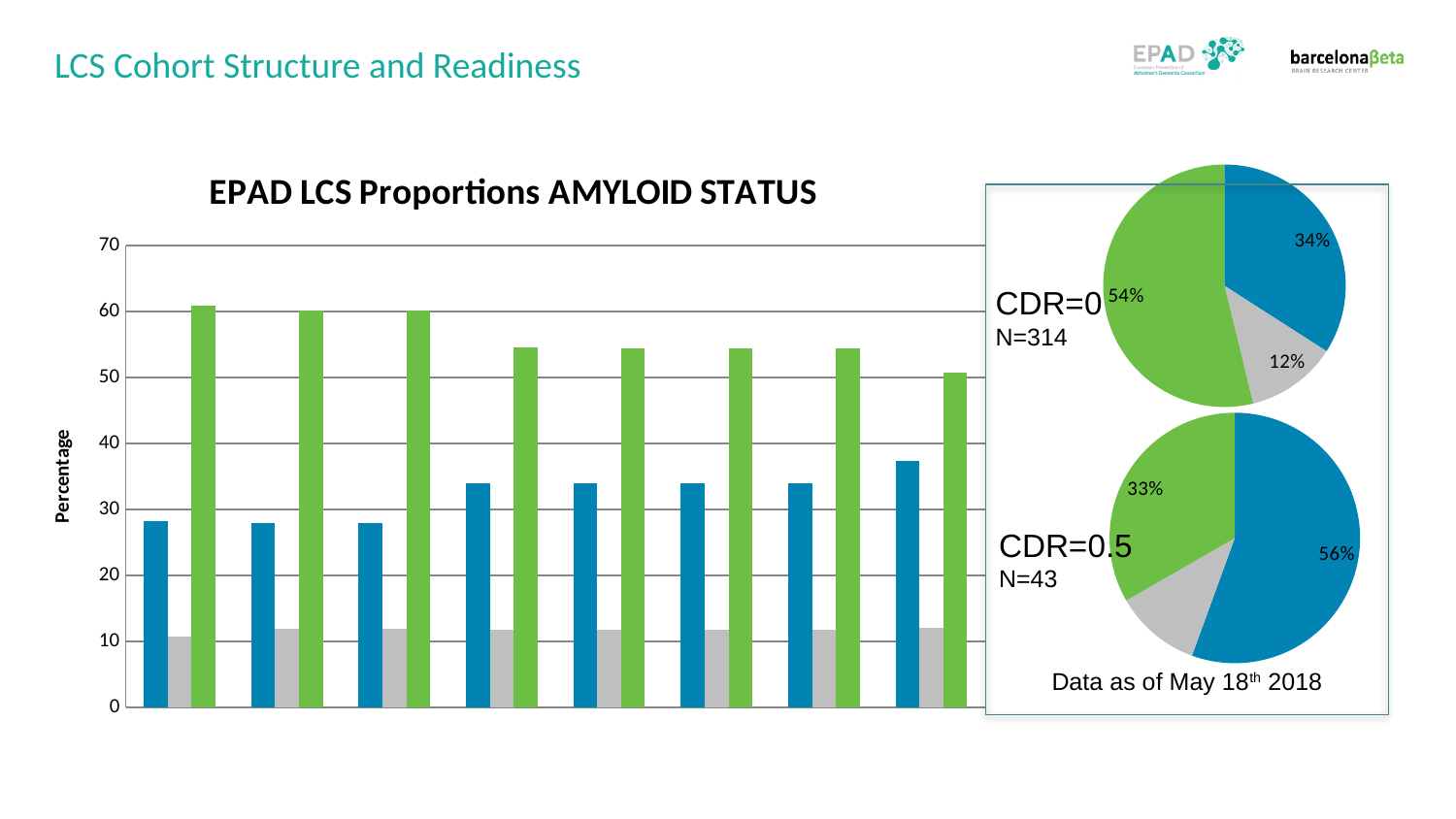
What kind of chart is the 'EPAD LCS Proportions AMYLOID STATUS' chart on the left of the slide? bar chart In the 'EPAD LCS Proportions AMYLOID STATUS' bar chart, is the value of the first blue bar greater or less than 40? less In the CDR=0 pie chart, what percentage is shown for the grey slice? 12% In the 'EPAD LCS Proportions AMYLOID STATUS' bar chart, is the value of the first grey bar greater or less than 20? less In the CDR=0.5 pie chart, what percentage is shown for the blue slice? 56% What is the label on the vertical axis of the 'EPAD LCS Proportions AMYLOID STATUS' bar chart? Percentage In the CDR=0 pie chart, what percentage is shown for the blue slice? 34% In the 'EPAD LCS Proportions AMYLOID STATUS' bar chart, what is the highest value shown on the vertical axis? 70 In the CDR=0 pie chart, what is the difference between the green slice and the blue slice? 20 percentage points In the 'EPAD LCS Proportions AMYLOID STATUS' bar chart, is the value of the first green bar greater or less than 50? greater In the CDR=0 pie chart, which slice is the largest? the green slice (54%) In the CDR=0.5 pie chart, which is larger, the blue slice or the green slice? the blue slice